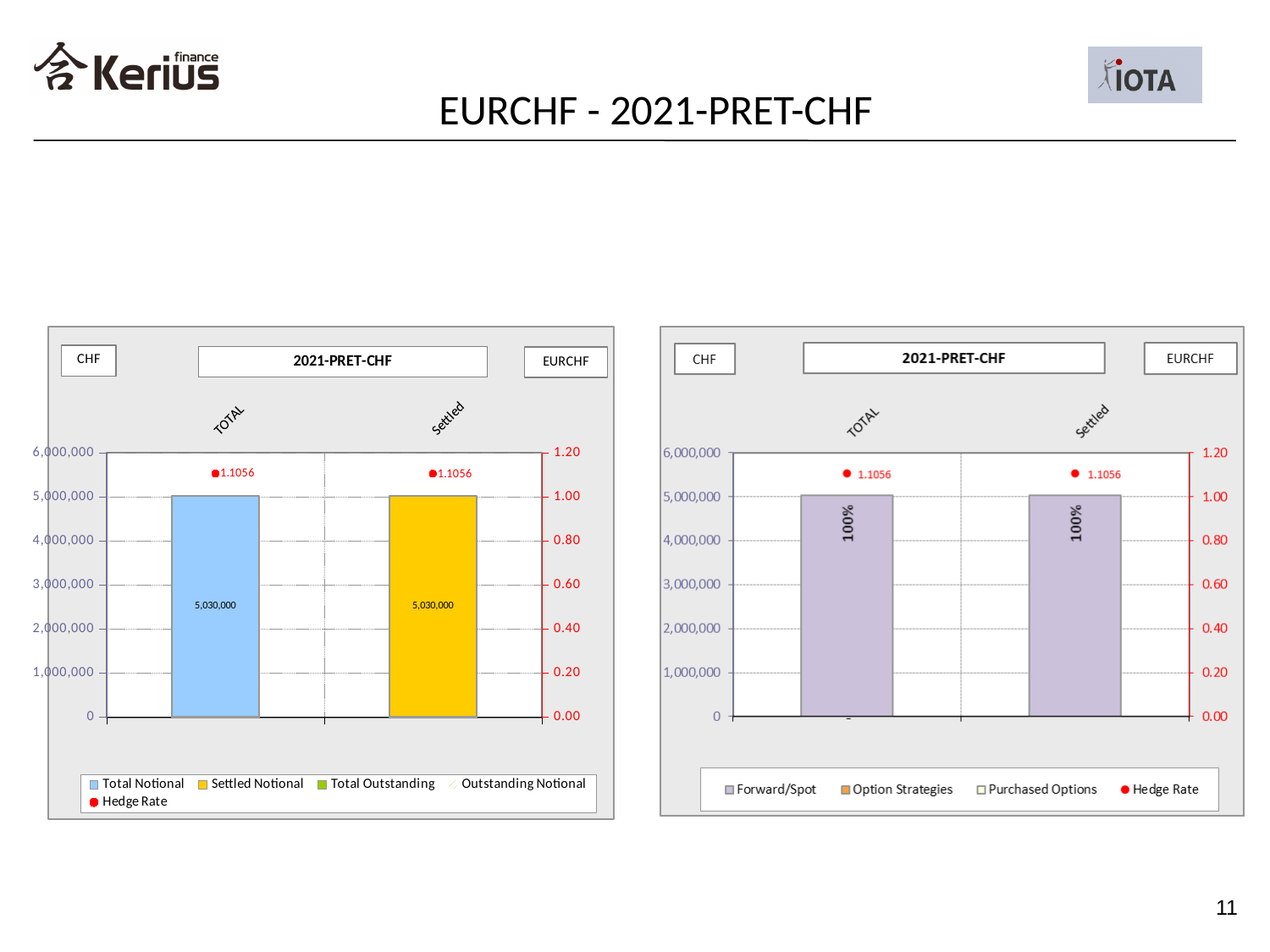
On the right chart, what Hedge Rate value is shown above the Settled bar? 1.1056 On the right chart, what percentage label is printed on the Settled bar? 100% How many categories are shown on the x axis of the left chart? 2 On the left chart, which legend entry is shown in yellow? Settled Notional On the left chart, what Hedge Rate value is shown above the TOTAL bar? 1.1056 On the right chart, what percentage label is printed on the TOTAL bar? 100% What kind of chart is the left chart? Combination bar and line chart (bars with Hedge Rate markers) On the left chart, what is the data label on the Settled bar? 5,030,000 On the left chart, what is the data label on the TOTAL bar? 5,030,000 How many entries does the legend of the right chart list? 4 On the left chart, is the value of the TOTAL bar greater or less than 4,000,000? greater How many entries does the legend of the left chart list? 5